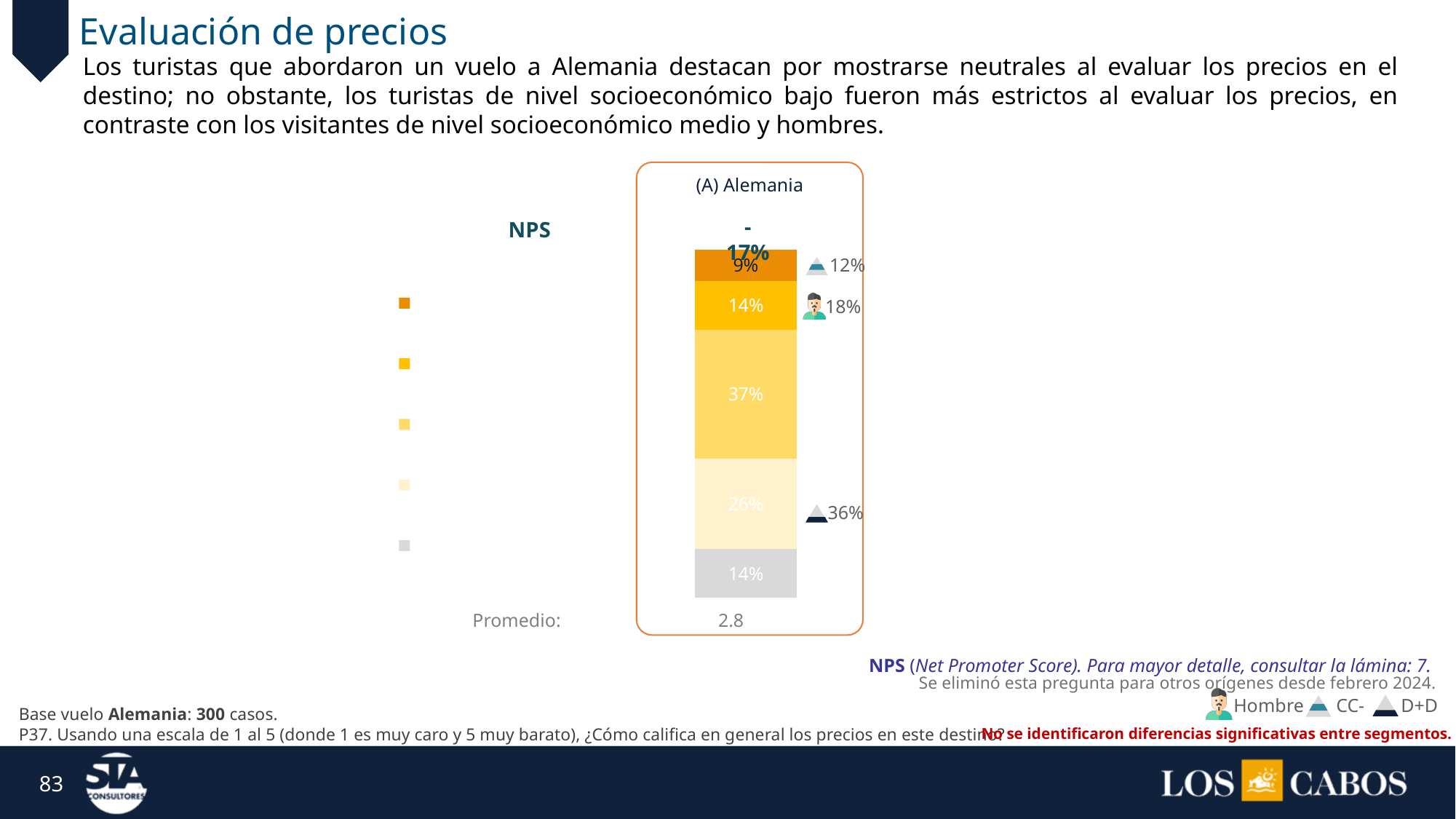
What NPS value is shown above the (A) Alemania bar? -17% What is the value of the largest segment in the (A) Alemania bar? 37% What kind of chart is shown on the slide? Stacked bar chart How many segments make up the stacked bar for (A) Alemania? 5 What is the 'Promedio' (average) shown below the (A) Alemania bar? 2.8 How many bars (categories) does the chart show? 1 What is the difference between the largest segment (37%) and the second-largest segment (26%) of the bar? 11 percentage points What is the value of the topmost (darkest orange) segment of the (A) Alemania bar? 9% What is the value of the bottom (grey) segment of the (A) Alemania bar? 14% What is the value of the smallest segment in the (A) Alemania bar? 9% What is the total of all segments in the (A) Alemania stacked bar? 100% Which is larger: the topmost segment (9%) or the bottom grey segment (14%) of the bar? The bottom grey segment (14%)